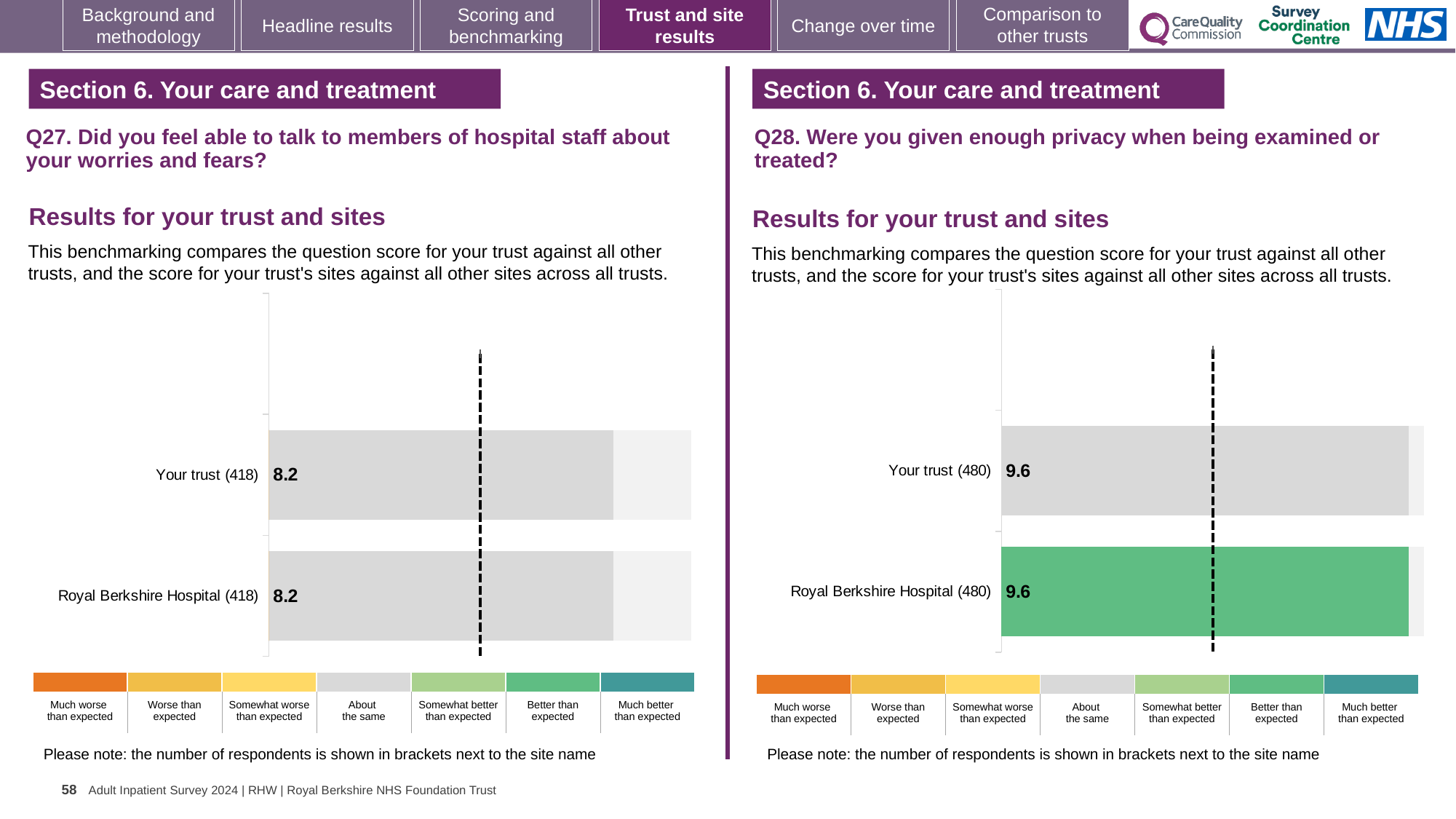
On the Q28 chart (right), which benchmark category does the green colour of the Royal Berkshire Hospital bar correspond to in the key? Better than expected On the Q27 chart (left), how many respondents are shown in brackets next to Royal Berkshire Hospital? 418 On the Q27 chart (left), what is the score for Your trust? 8.2 How many bars are plotted on the Q28 chart (right)? 2 On the Q28 chart (right), what is the difference between the score for Your trust and the score for Royal Berkshire Hospital? 0 On the Q27 chart (left), what is the difference between the score for Your trust and the score for Royal Berkshire Hospital? 0 On the Q28 chart (right), how many respondents are shown in brackets next to Your trust? 480 On the Q28 chart (right), what is the score for Royal Berkshire Hospital? 9.6 What type of chart is used on the Q28 chart (right)? Bar chart On the Q28 chart (right), what is the score for Your trust? 9.6 How many bars are plotted on the Q27 chart (left)? 2 On the Q27 chart (left), what is the score for Royal Berkshire Hospital? 8.2